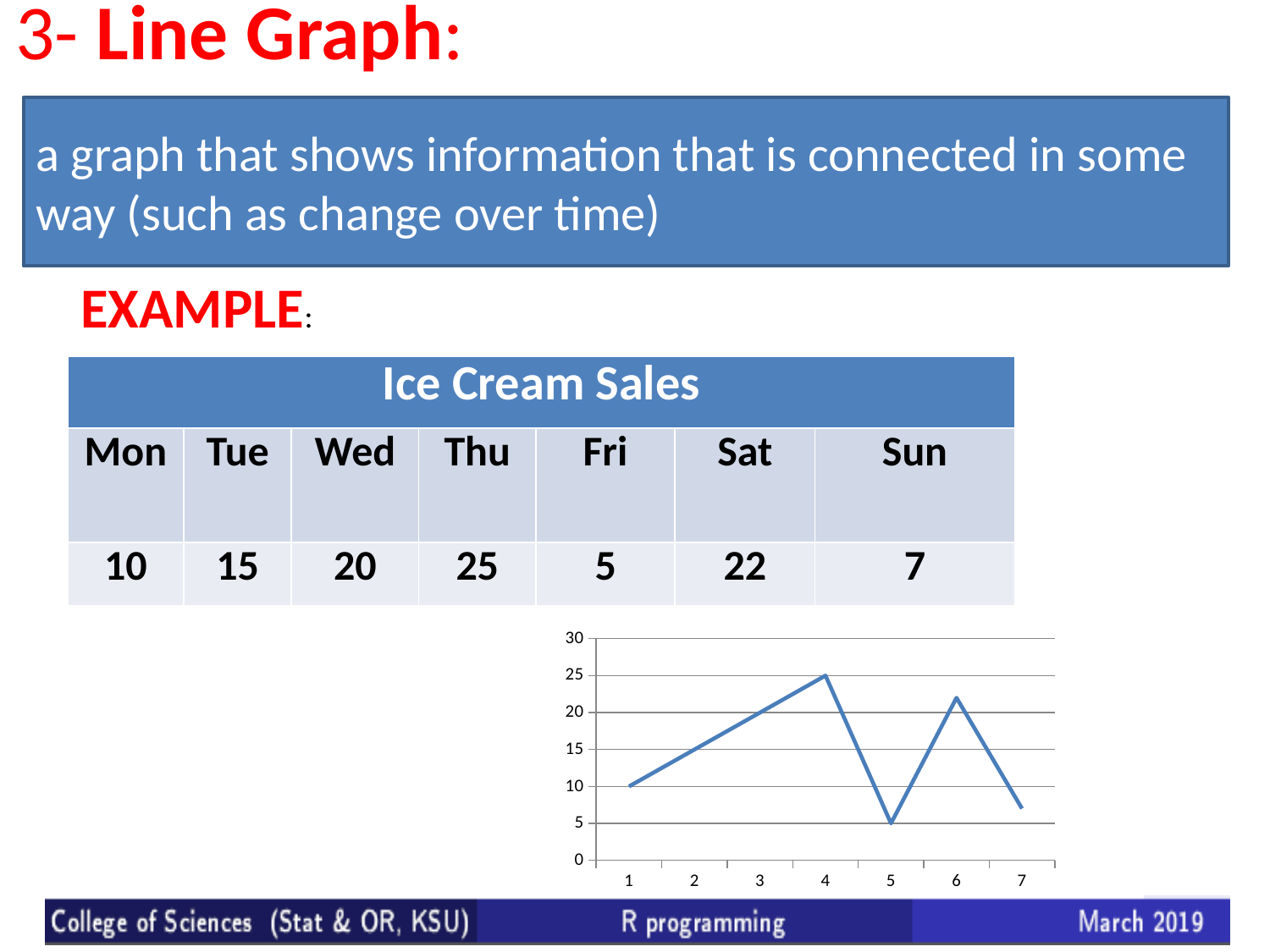
Is the value at x = 6 on the line chart greater or less than 20? greater What is the difference between the value at x = 4 and the value at x = 5 on the line chart? 20 What is the value at x = 4 on the line chart? 25 What is the value at x = 3 on the line chart? 20 How many points are plotted on the line chart? 7 What is the value at x = 5 on the line chart? 5 Is the value at x = 7 on the line chart greater or less than 10? less Do the values on the line chart rise or fall from x = 1 to x = 4? rise At which x value does the line chart reach its lowest point? 5 What is the value at x = 1 on the line chart? 10 What kind of chart is shown at the bottom of the slide? line chart At which x value does the line chart reach its highest point? 4